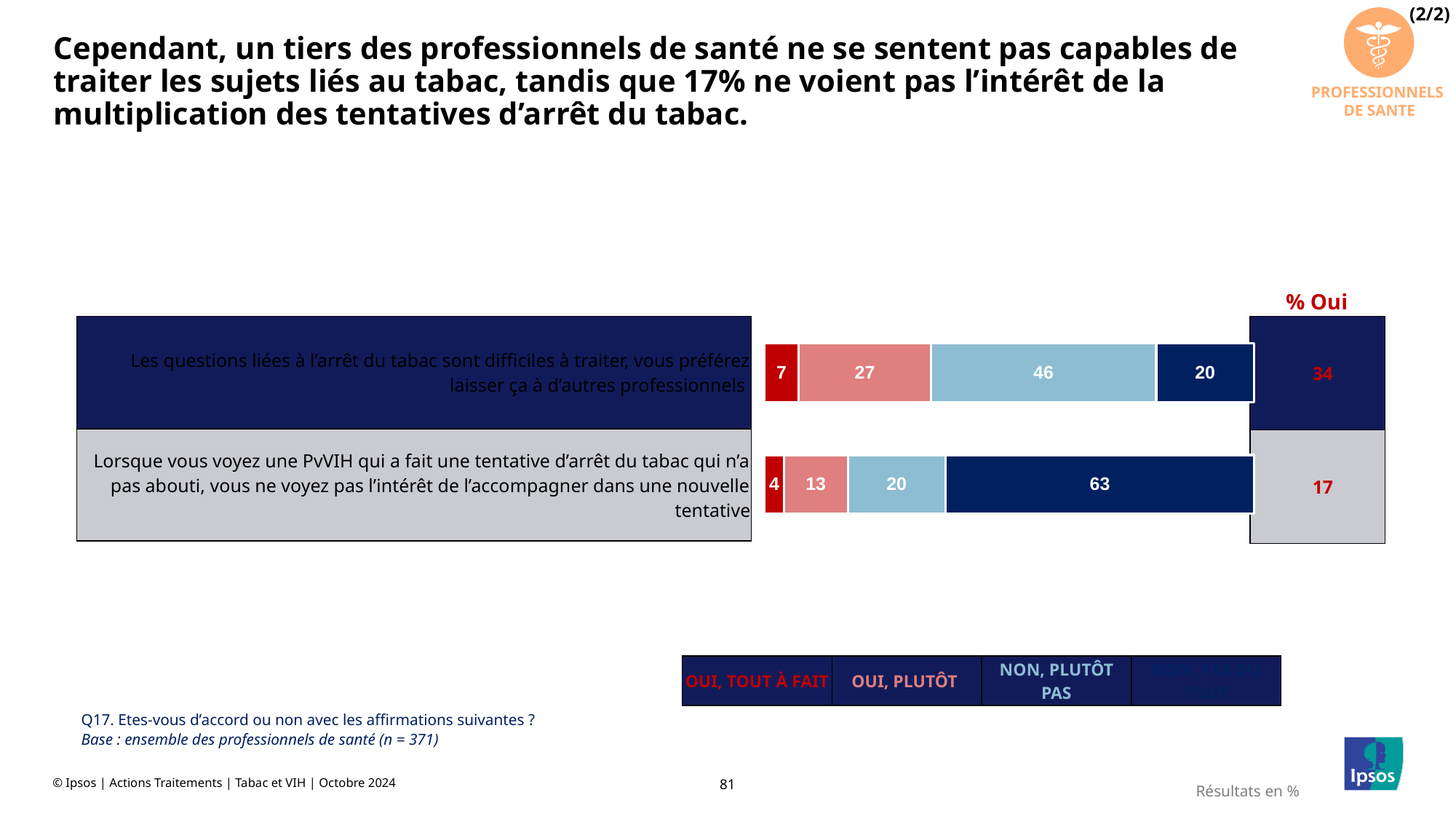
How many statements (bars) are shown on the chart? 2 Which statement has the higher "% Oui" value? Les questions liées à l'arrêt du tabac sont difficiles à traiter, vous préférez laisser ça à d'autres professionnels What is the "Oui, tout à fait" value for the statement "Les questions liées à l'arrêt du tabac sont difficiles à traiter, vous préférez laisser ça à d'autres professionnels"? 7 What is the difference between the "Non, plutôt pas" values of the two statements? 26 What is the largest segment value in the bar for the statement "Lorsque vous voyez une PvVIH qui a fait une tentative d'arrêt du tabac qui n'a pas abouti..."? 63 What is the difference between the two "% Oui" values shown on the chart? 17 What is the "Non, plutôt pas" value for the statement "Lorsque vous voyez une PvVIH qui a fait une tentative d'arrêt du tabac qui n'a pas abouti, vous ne voyez pas l'intérêt de l'accompagner dans une nouvelle tentative"? 20 What is the "Oui, plutôt" value for the statement "Les questions liées à l'arrêt du tabac sont difficiles à traiter, vous préférez laisser ça à d'autres professionnels"? 27 What is the total of the segments in the bar for the statement "Les questions liées à l'arrêt du tabac sont difficiles à traiter..."? 100 What type of chart is shown on the slide? Stacked bar chart What is the "% Oui" value for the statement "Les questions liées à l'arrêt du tabac sont difficiles à traiter, vous préférez laisser ça à d'autres professionnels"? 34 What is the "% Oui" value for the statement "Lorsque vous voyez une PvVIH qui a fait une tentative d'arrêt du tabac qui n'a pas abouti..."? 17